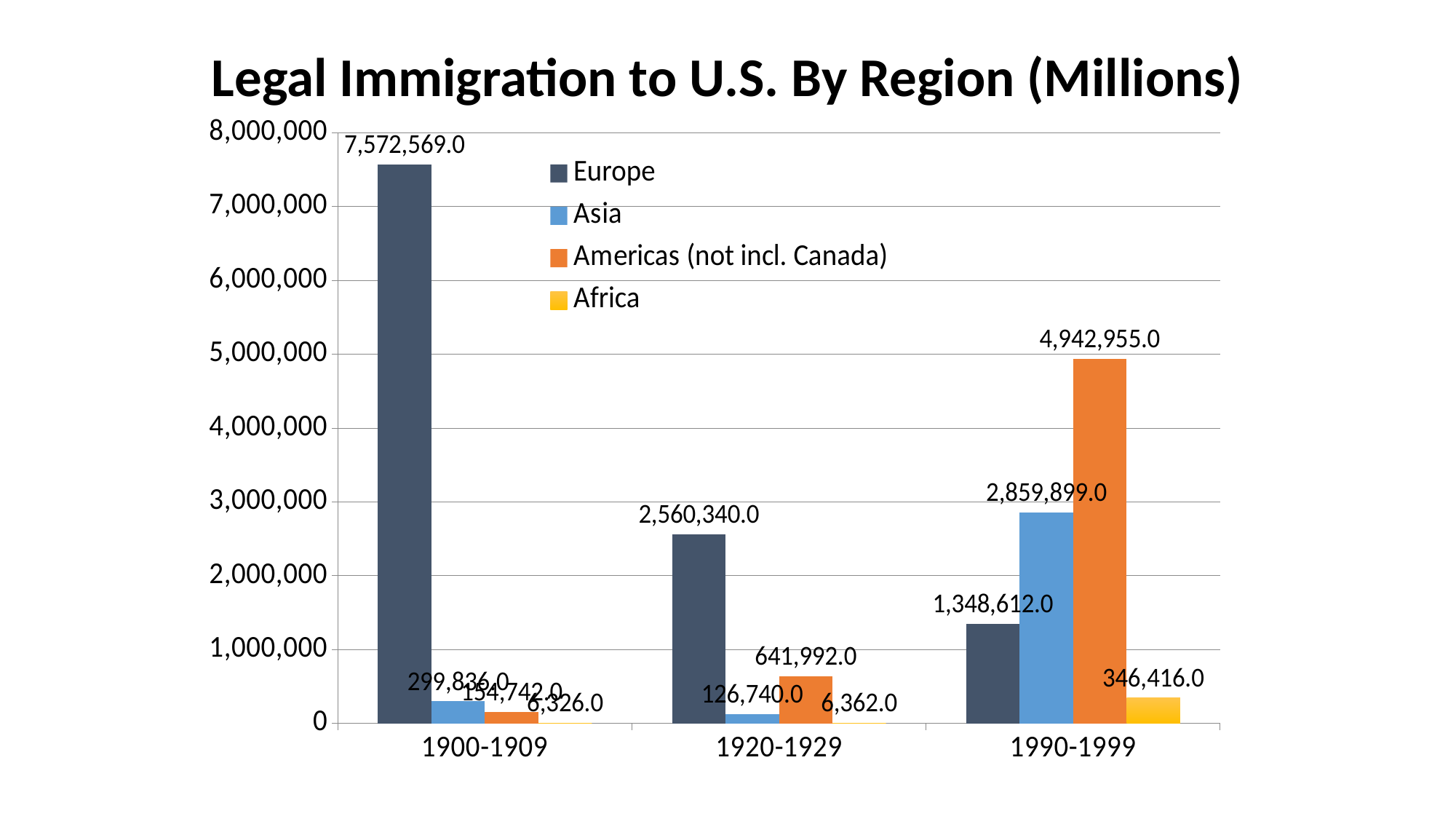
Which region has the lowest value in 1920-1929? Africa What is the value for Asia in 1920-1929? 126,740.0 What is the difference between the Europe value in 1920-1929 and the Europe value in 1990-1999? 1,211,728.0 Which region has the highest value in 1990-1999? Americas (not incl. Canada) Is the value for Europe in 1920-1929 greater or less than 3,000,000? less In 1990-1999, which is larger: the value for Asia or the value for Europe? Asia What is the value for Africa in 1990-1999? 346,416.0 How many time periods are shown on the x axis? 3 What is the value for Americas (not incl. Canada) in 1990-1999? 4,942,955.0 Does the value for Europe rise or fall across the periods from 1900-1909 to 1990-1999? fall How many series does the legend list? 4 What is the value for Europe in 1900-1909? 7,572,569.0